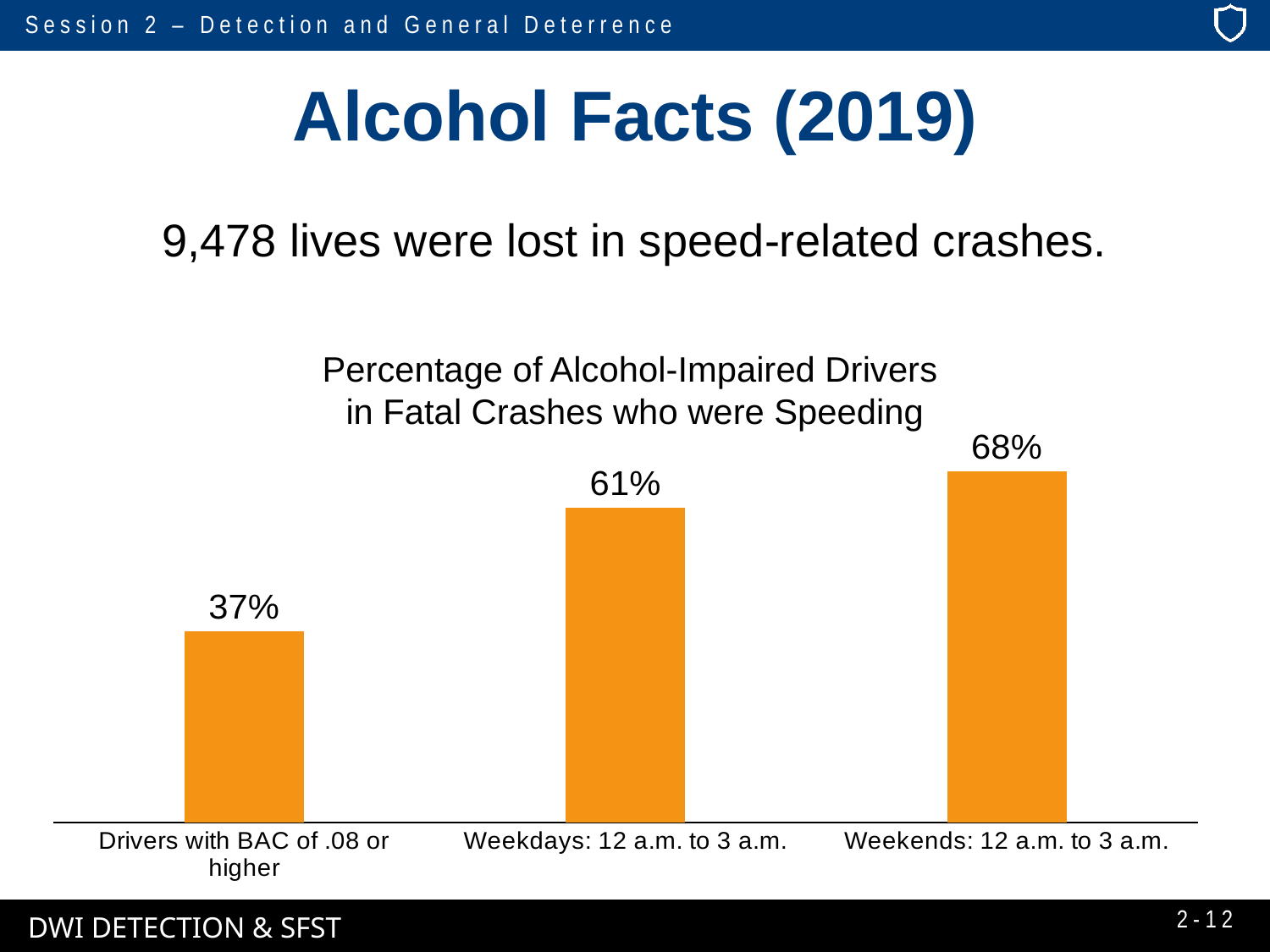
Which category has the highest percentage? Weekends: 12 a.m. to 3 a.m. What is the value for Weekdays: 12 a.m. to 3 a.m.? 61% What is the difference between the Weekdays: 12 a.m. to 3 a.m. value and the Drivers with BAC of .08 or higher value? 24% What kind of chart is shown on the slide? Bar chart How many categories are shown in the chart? 3 Which category has the lowest percentage? Drivers with BAC of .08 or higher Which is larger: the value for Weekdays: 12 a.m. to 3 a.m. or the value for Drivers with BAC of .08 or higher? Weekdays: 12 a.m. to 3 a.m. What is the title of the chart? Percentage of Alcohol-Impaired Drivers in Fatal Crashes who were Speeding What is the value for Drivers with BAC of .08 or higher? 37% What is the difference between the Weekends: 12 a.m. to 3 a.m. value and the Weekdays: 12 a.m. to 3 a.m. value? 7% Do the values rise or fall from left to right across the categories? Rise What is the value for Weekends: 12 a.m. to 3 a.m.? 68%